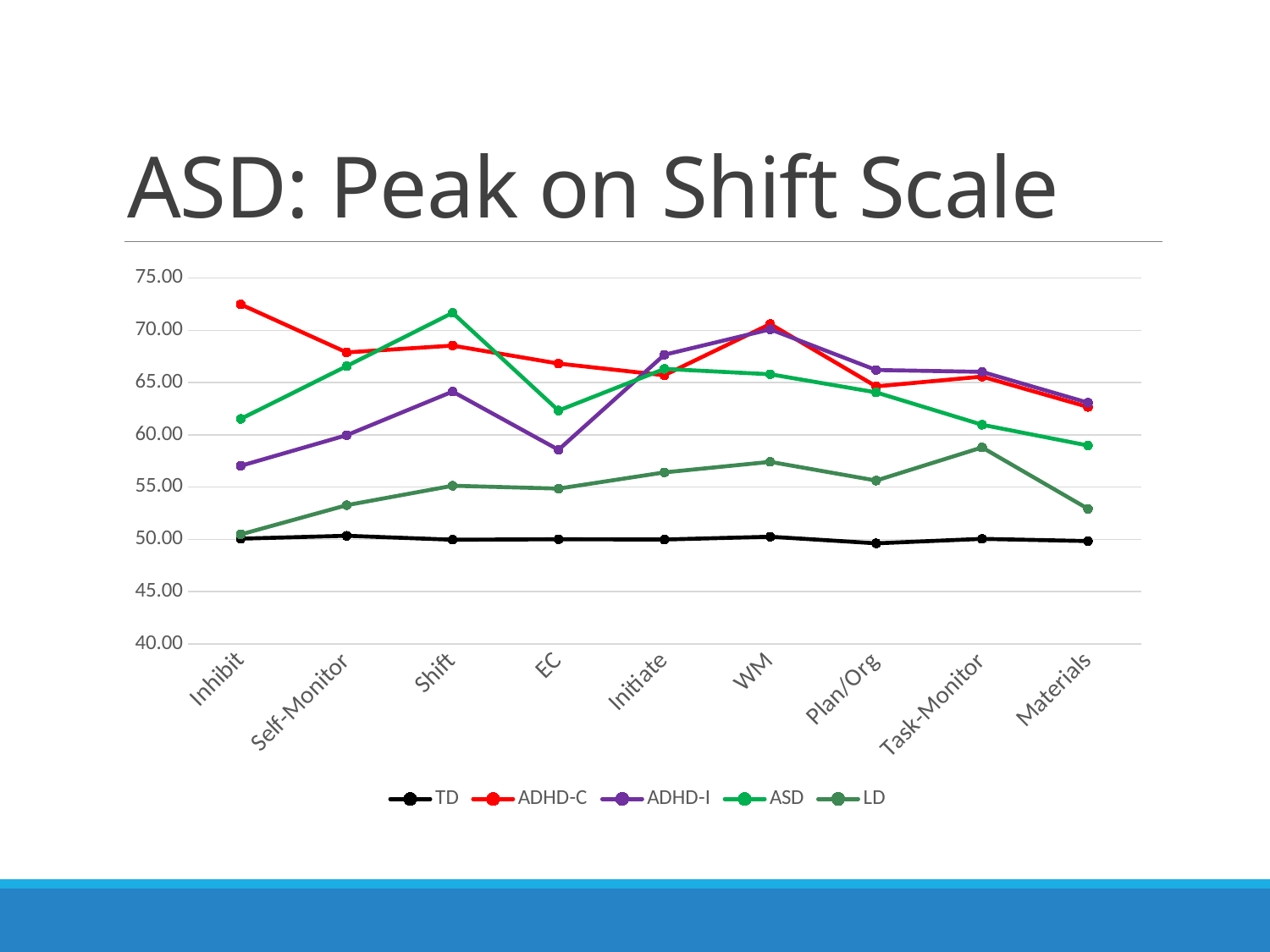
Is the LD value for Inhibit greater or less than 55.00? less At Inhibit, which series has the larger value, ADHD-C or ASD? ADHD-C Does the ASD series rise or fall from Initiate to Materials? fall For the ADHD-I series, which category has the lowest value? Inhibit What kind of chart is shown on the slide? line chart For the ASD series, which category has the highest value? Shift How many categories are shown along the x axis? 9 What is the title of the slide? ASD: Peak on Shift Scale How many series does the legend list? 5 Is the ASD value for Shift greater or less than 70.00? greater At Shift, which series has the larger value, ASD or ADHD-C? ASD For the ADHD-C series, which category has the highest value? Inhibit